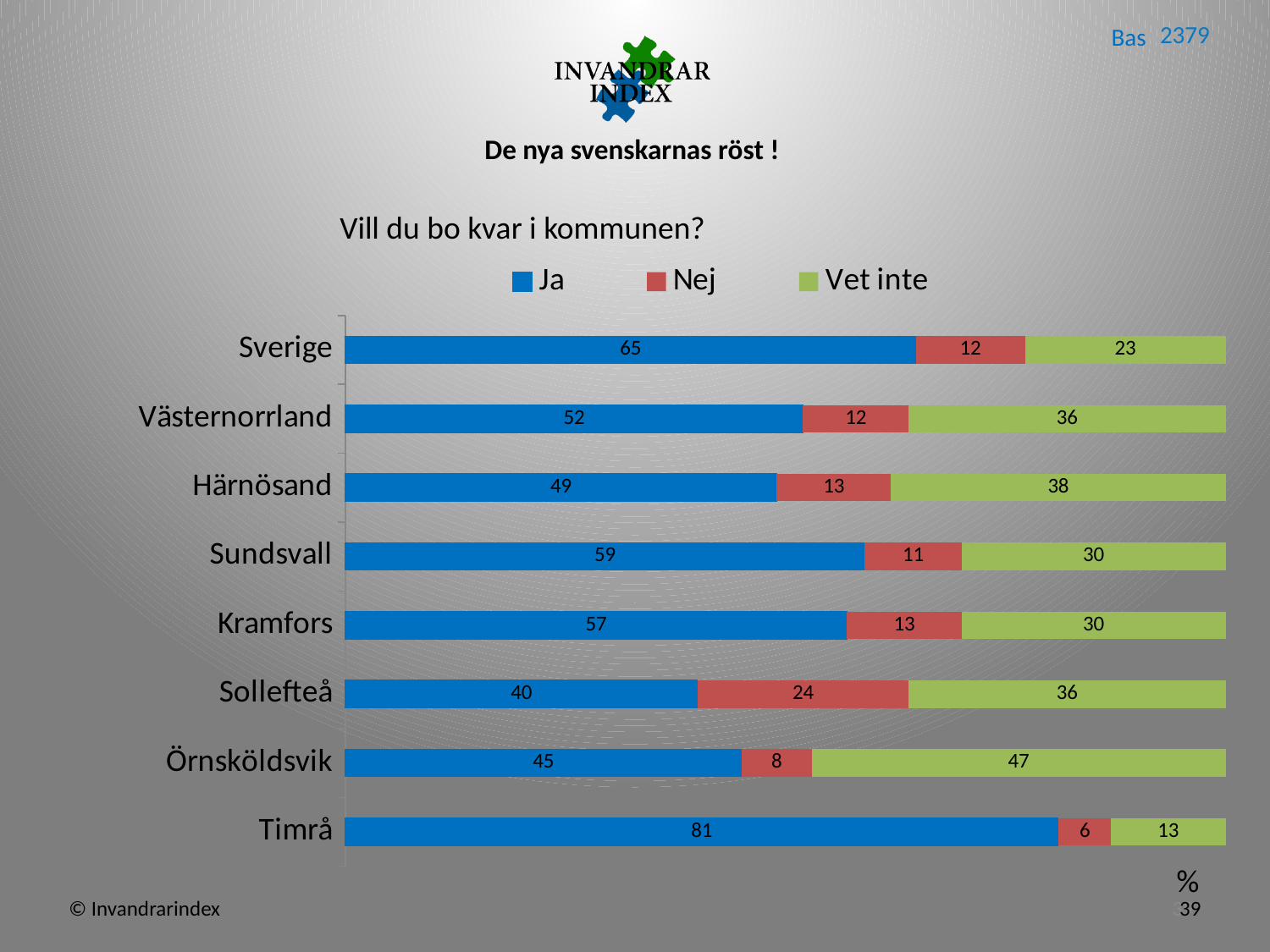
How many series does the legend list? 3 Which category has the highest value for Ja? Timrå What is the total of the stacked bar for Kramfors? 100 Which is larger, the Vet inte value for Härnösand or for Sundsvall? Härnösand What is the title of the chart? Vill du bo kvar i kommunen? What is the value for Vet inte for Örnsköldsvik? 47 What kind of chart is shown on the slide? Stacked bar chart How many categories are shown on the chart? 8 Which category has the lowest value for Nej? Timrå What is the difference between the Ja values for Sverige and Västernorrland? 13 What is the value for Nej for Sollefteå? 24 What is the value for Ja for Timrå? 81